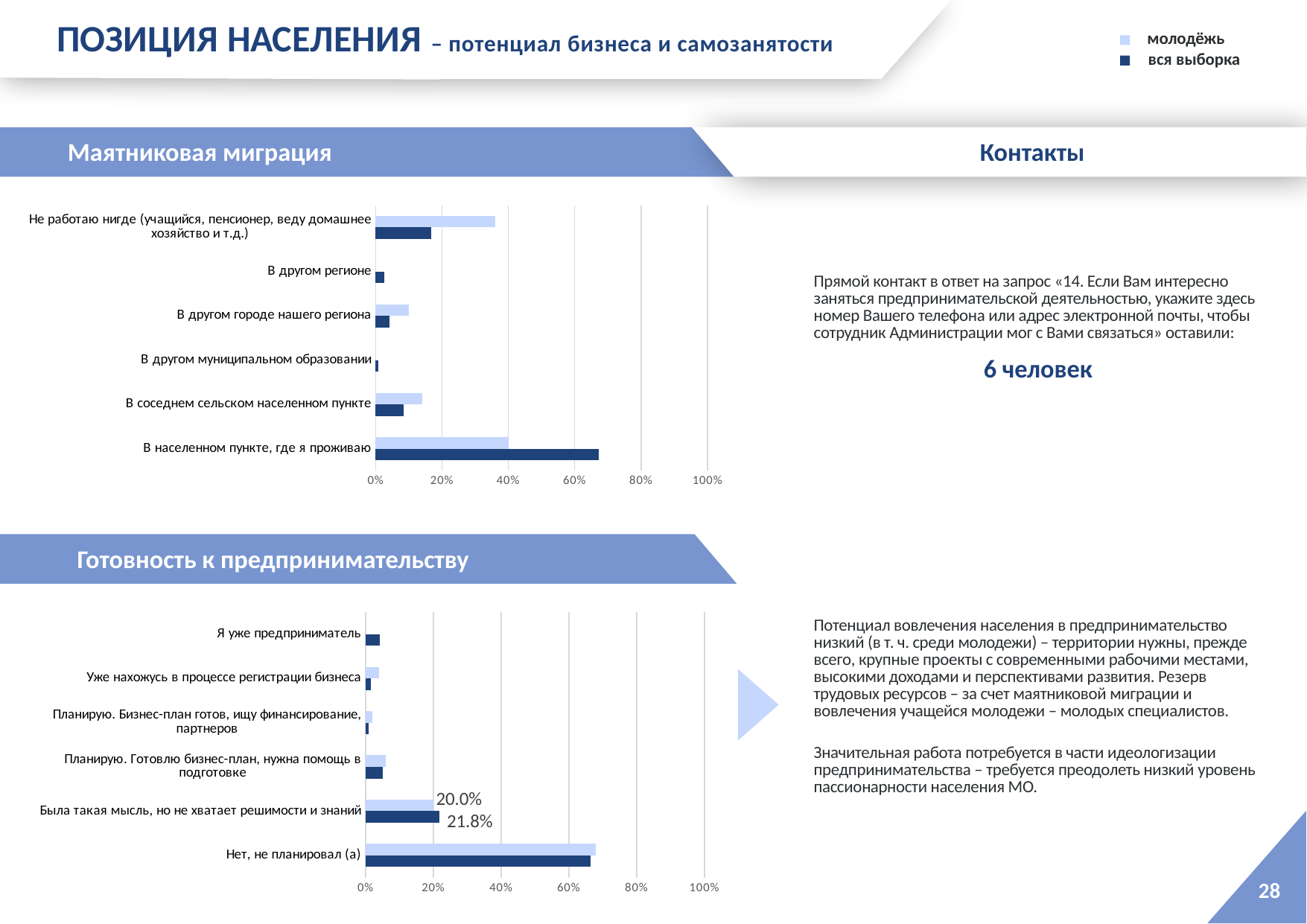
What kind of chart is the "Маятниковая миграция" chart? bar chart In the "Маятниковая миграция" chart, which category has the highest value for "вся выборка"? В населенном пункте, где я проживаю How many series does the legend at the top of the slide list? 2 How many categories does the "Маятниковая миграция" chart show? 6 In the "Готовность к предпринимательству" chart, what is the value for "молодёжь" in the category "Была такая мысль, но не хватает решимости и знаний"? 20.0% In the "Готовность к предпринимательству" chart, which series has the larger value for "Была такая мысль, но не хватает решимости и знаний"? вся выборка In the "Готовность к предпринимательству" chart, what is the value for "вся выборка" in the category "Была такая мысль, но не хватает решимости и знаний"? 21.8% How many categories does the "Готовность к предпринимательству" chart show? 6 In the "Готовность к предпринимательству" chart, which category has the highest value for "молодёжь"? Нет, не планировал(а) What are the two legend entries shown at the top of the slide? молодёжь, вся выборка In the "Маятниковая миграция" chart, is the value for "вся выборка" in "В населенном пункте, где я проживаю" greater or less than 60%? greater In the "Готовность к предпринимательству" chart, what is the difference between "вся выборка" and "молодёжь" for "Была такая мысль, но не хватает решимости и знаний"? 1.8%